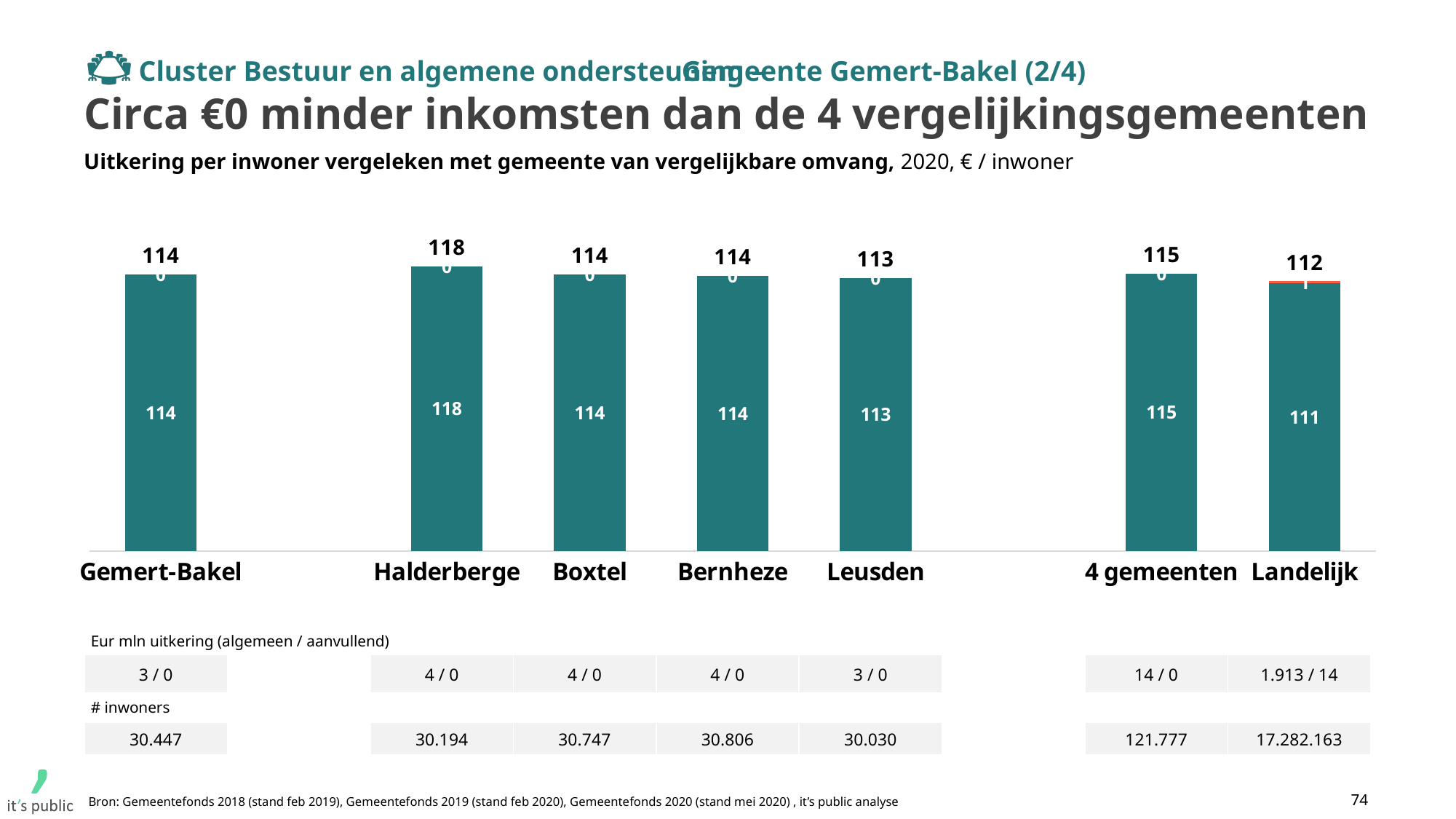
What is the total value shown above the bar for Landelijk? 112 What kind of chart is shown on the slide? bar chart How many categories are shown on the x axis of the chart? 7 What is the total value shown above the bar for Gemert-Bakel? 114 What is the total value shown above the bar for Halderberge? 118 What is the difference between the total for 4 gemeenten and the total for Gemert-Bakel? 1 Which has a larger total value, Halderberge or Leusden? Halderberge What is the value of the orange segment on top of the Landelijk bar? 1 What is the value of the teal segment of the Landelijk bar? 111 Which category has the lowest total value? Landelijk Which category has the highest total value? Halderberge What is the difference between the total for Halderberge and the total for Leusden? 5